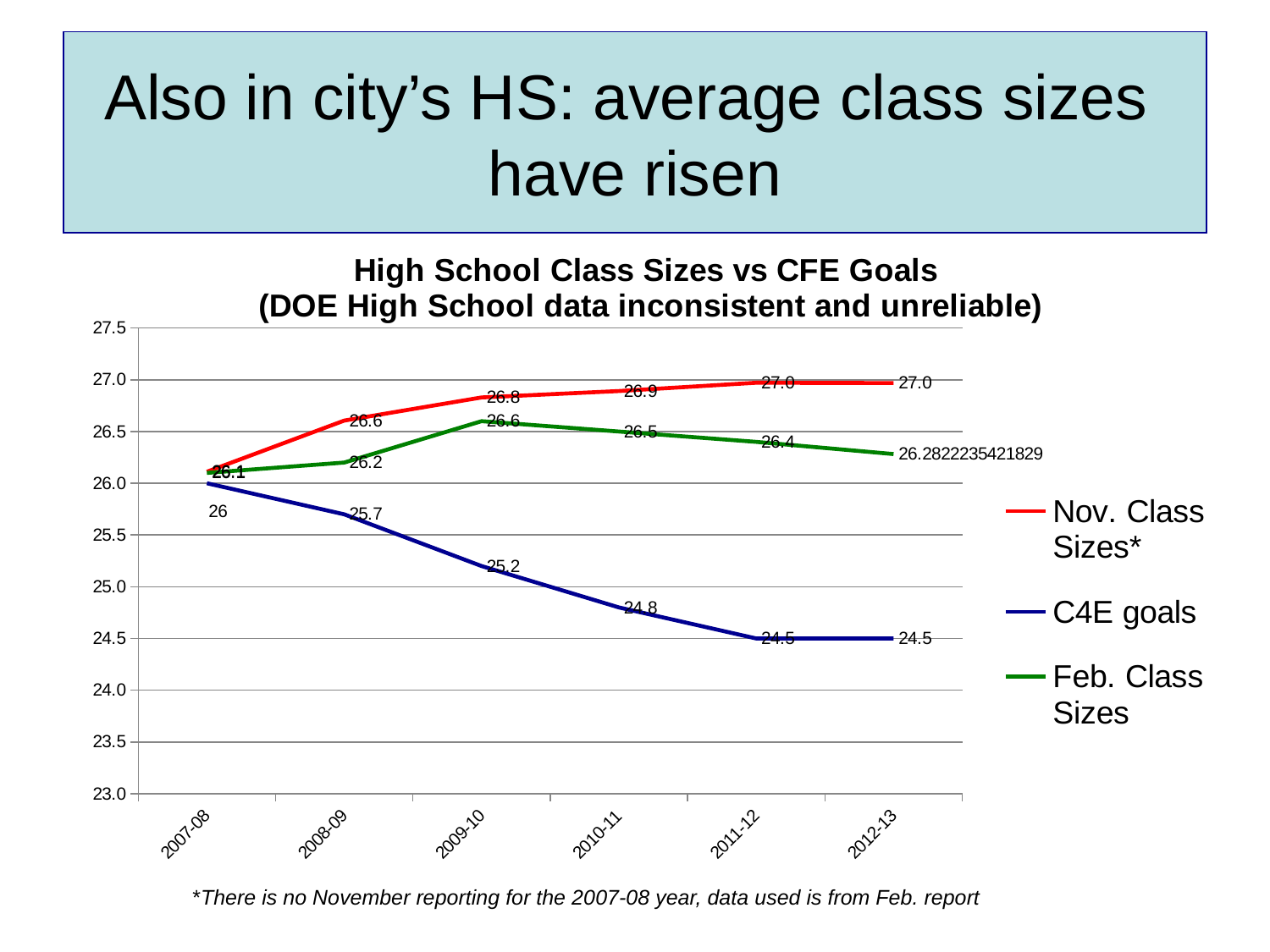
Do the C4E goals values rise or fall from 2007-08 to 2012-13? fall What colour is the line for Feb. Class Sizes? green Which is larger in 2010-11, the Nov. Class Sizes* value or the Feb. Class Sizes value? Nov. Class Sizes* What is the C4E goals value for 2010-11? 24.8 What type of chart is shown on the slide? line chart What is the C4E goals value for 2012-13? 24.5 What is the Nov. Class Sizes* value for 2009-10? 26.8 What is the Feb. Class Sizes value for 2011-12? 26.4 How many school years are shown on the x axis? 6 What is the difference between the Nov. Class Sizes* value and the C4E goals value in 2011-12? 2.5 In which year is the C4E goals value highest? 2007-08 How many series does the legend list? 3